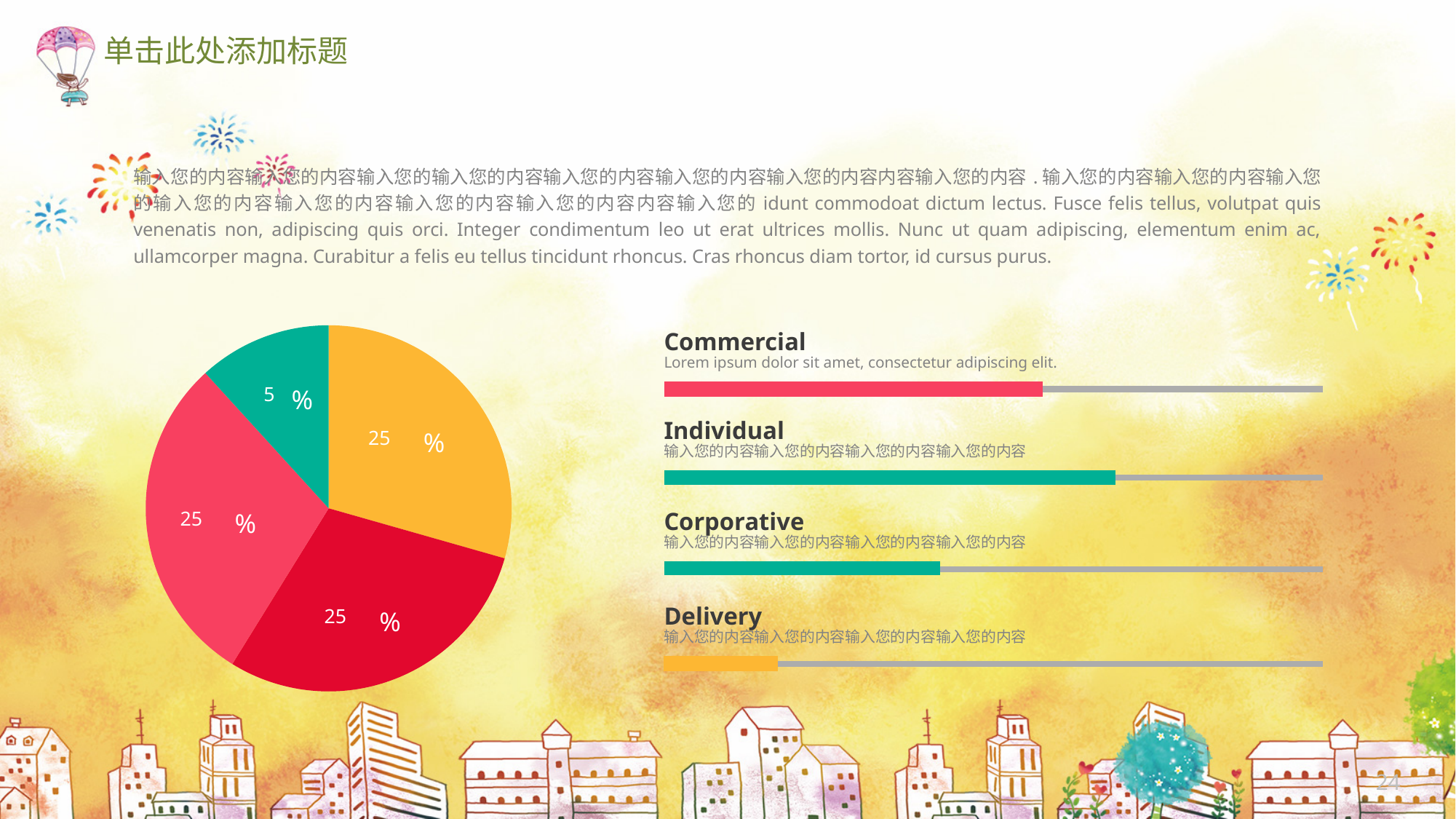
What value is printed on the yellow slice of the pie chart? 25 % How many slices does the pie chart have? 4 Is the value printed on the yellow slice of the pie chart larger or smaller than the value on the teal slice? larger What kind of chart is shown on the left of the slide? pie chart What is the difference between the value printed on the red slice and the value printed on the teal slice of the pie chart? 20 % What value is printed on the pink slice of the pie chart? 25 % How many slices of the pie chart are labelled 25 %? 3 What value is printed on the teal slice of the pie chart? 5 % Does the pie chart have a legend naming its slices? No What value is printed on the red slice of the pie chart? 25 % Which slice of the pie chart has the smallest printed value? the teal slice (5 %) What colour is the slice of the pie chart labelled 5 %? teal